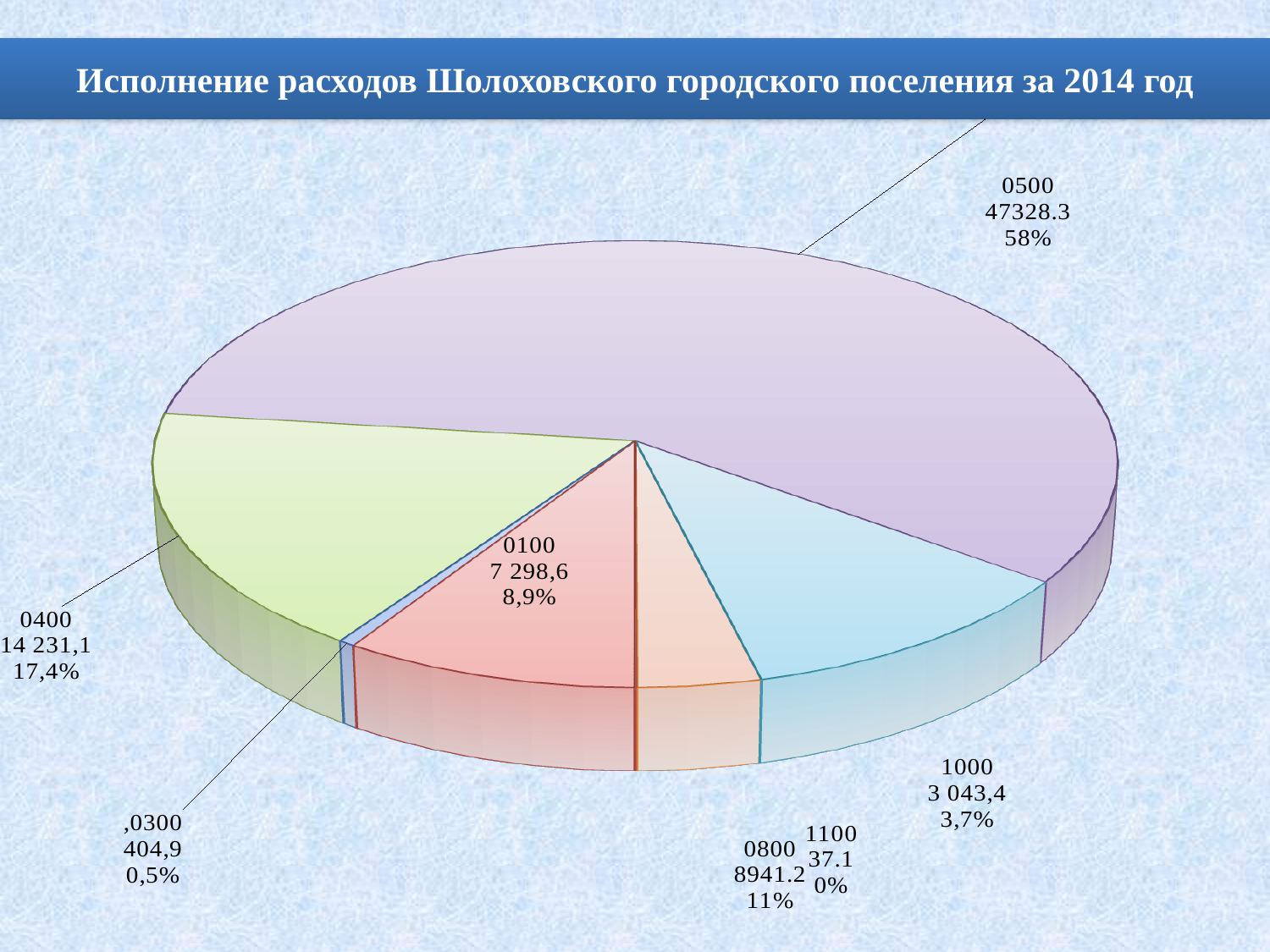
Which category has the smallest slice of the pie? 1100 Which category has the largest slice of the pie? 0500 What value is shown for category 0100? 7 298,6 What is the title of the chart on the slide? Исполнение расходов Шолоховского городского поселения за 2014 год What value is shown for category 0500? 47328.3 What value is shown for category 0400? 14 231,1 What share of the pie does category 0800 represent? 11% What share of the pie does category 0500 represent? 58% Which is larger, the value for 1000 or the value for 0300? 1000 What share of the pie does category 0400 represent? 17,4% How many slices does the pie chart have? 7 What kind of chart is shown on the slide? pie chart